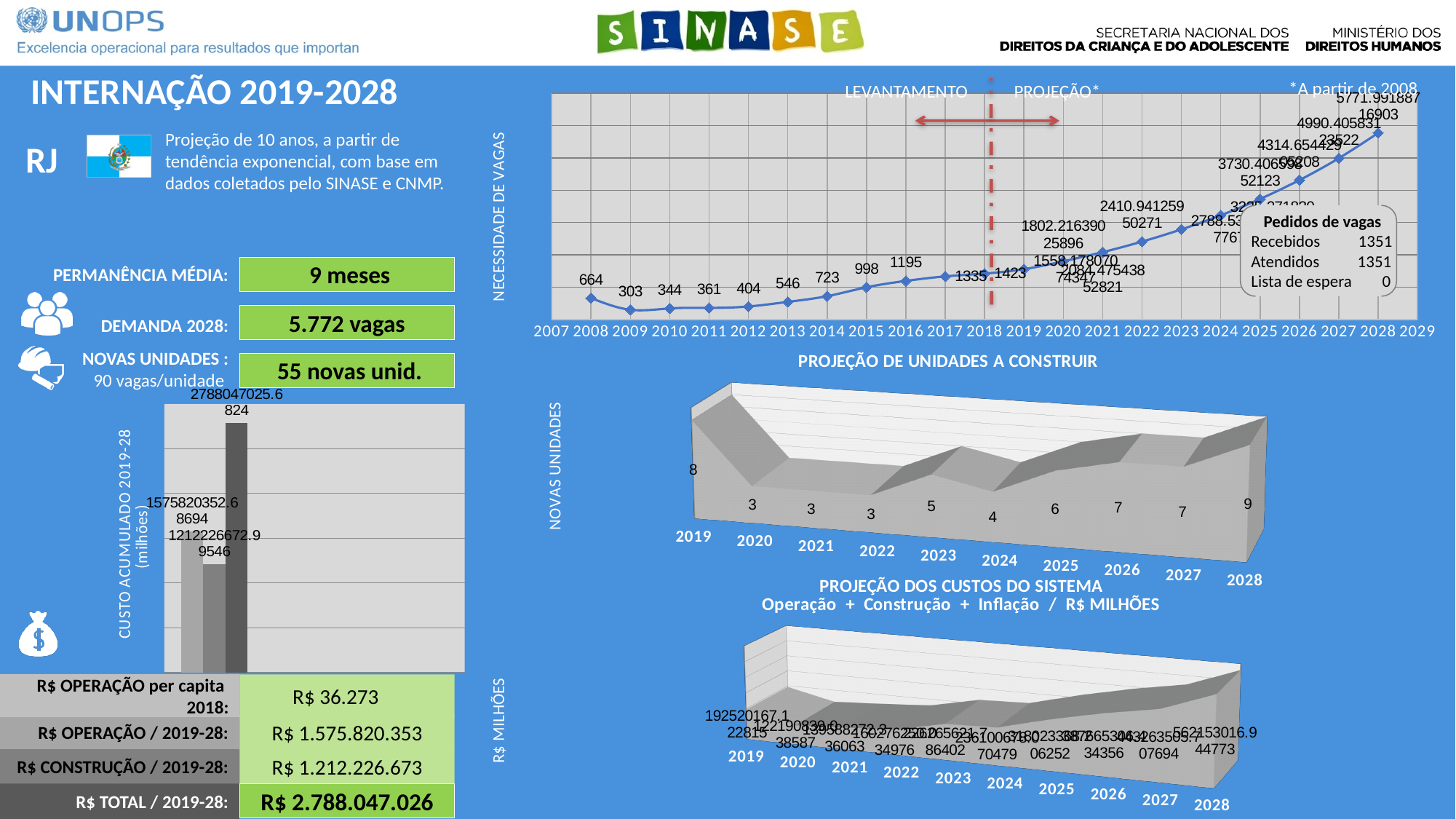
What kind of chart is the CUSTO ACUMULADO 2019-28 chart at the bottom left? bar chart In the line chart at the top right (NECESSIDADE DE VAGAS), what is the value for 2008? 664 In the line chart at the top right (NECESSIDADE DE VAGAS), which year has the lowest value? 2009 In the line chart at the top right (NECESSIDADE DE VAGAS), what is the value for 2018? 1423 In the chart titled PROJEÇÃO DE UNIDADES A CONSTRUIR, what is the difference between the values for 2028 and 2019? 1 In the chart titled PROJEÇÃO DE UNIDADES A CONSTRUIR, how many years are plotted? 10 In the chart titled PROJEÇÃO DE UNIDADES A CONSTRUIR, which year has more new units, 2023 or 2024? 2023 In the chart titled PROJEÇÃO DE UNIDADES A CONSTRUIR, how many new units are projected for 2019? 8 In the chart titled PROJEÇÃO DE UNIDADES A CONSTRUIR, what is the lowest number of new units shown for any year? 3 In the line chart at the top right (NECESSIDADE DE VAGAS), what is the difference between the values for 2017 and 2016? 140 In the chart titled PROJEÇÃO DE UNIDADES A CONSTRUIR, how many new units are projected for 2028? 9 In the chart titled PROJEÇÃO DE UNIDADES A CONSTRUIR, which year has the highest number of new units? 2028